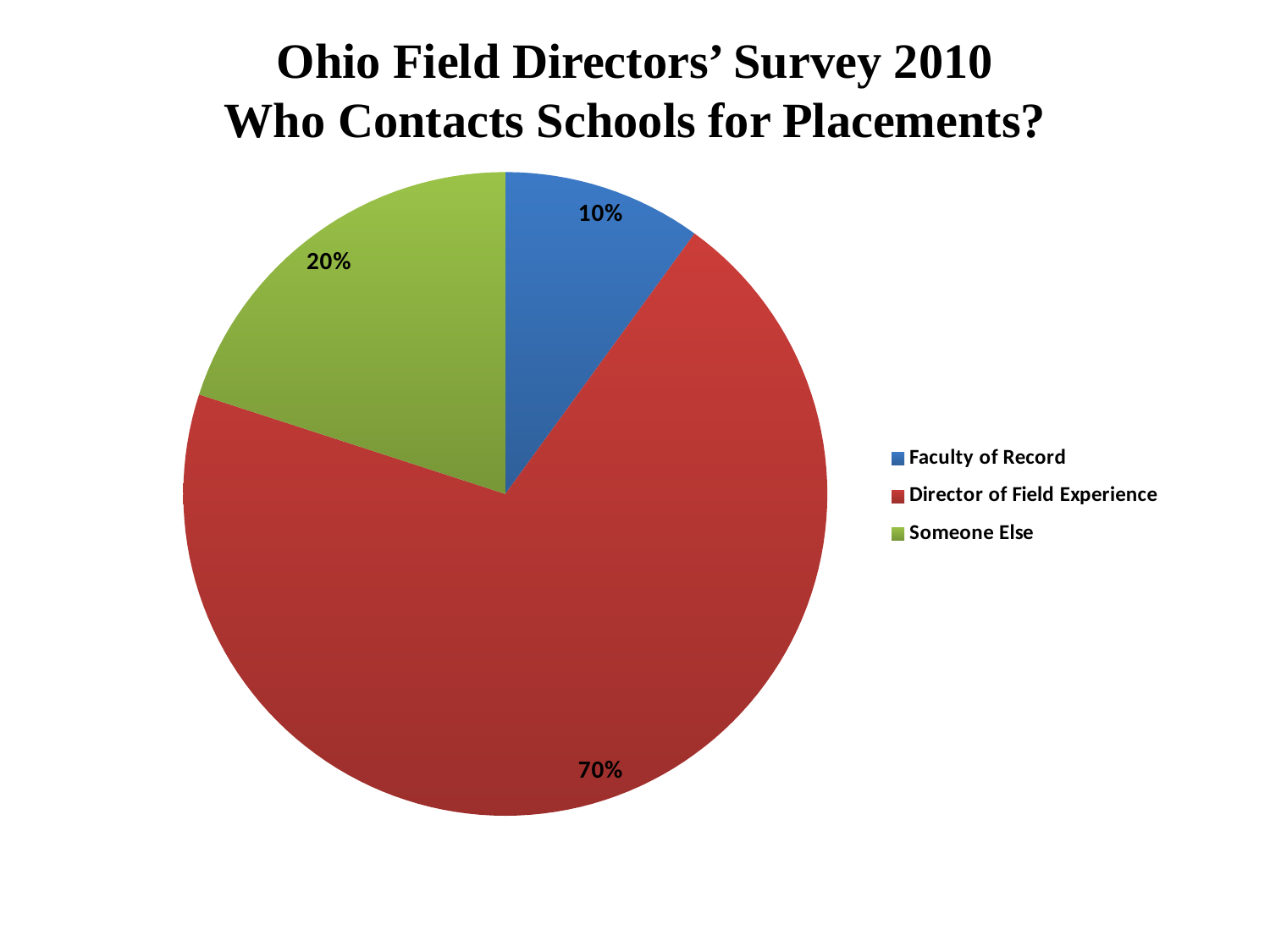
Which category has the largest share of the pie? Director of Field Experience What percentage of the pie is Someone Else? 20% Which category has the smallest share of the pie? Faculty of Record What colour is the slice for Someone Else? green What percentage of the pie is Faculty of Record? 10% What kind of chart is shown on the slide? pie chart What is the difference in percentage points between Director of Field Experience and Someone Else? 50 Which is larger, the share for Someone Else or the share for Faculty of Record? Someone Else What percentage of the pie is Director of Field Experience? 70% What is the difference in percentage points between Someone Else and Faculty of Record? 10 How many categories does the pie chart show? 3 What is the title of the chart? Ohio Field Directors' Survey 2010 Who Contacts Schools for Placements?